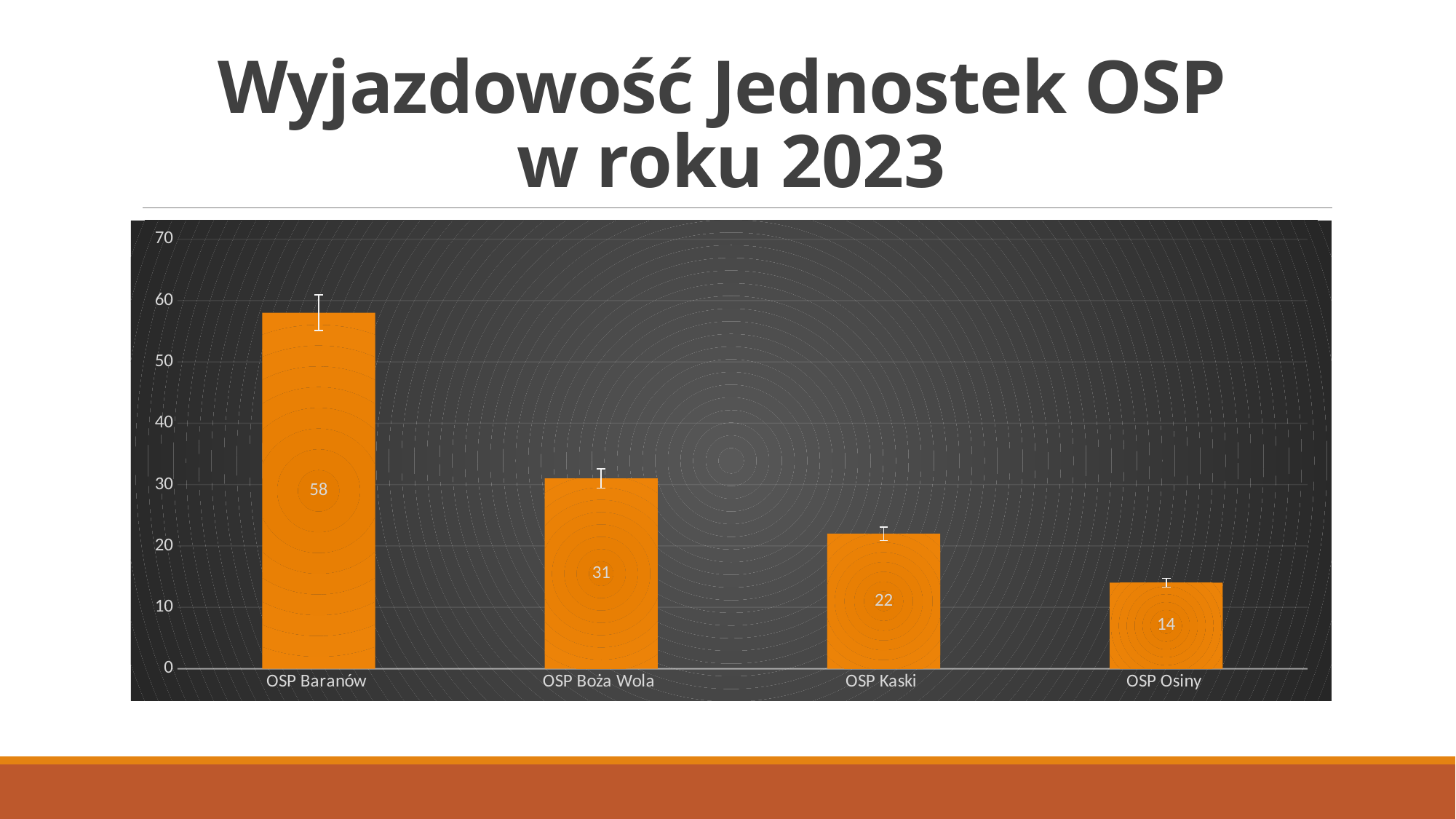
What is the difference between the values for OSP Kaski and OSP Osiny? 8 What is the value for OSP Osiny? 14 How many units are shown on the chart? 4 What is the value for OSP Baranów? 58 What is the value for OSP Kaski? 22 Which unit has the highest value? OSP Baranów What kind of chart is shown on the slide? Bar chart Which unit has the lowest value? OSP Osiny Do the values rise or fall from left to right across the chart? Fall What is the value for OSP Boża Wola? 31 Which is larger, the value for OSP Boża Wola or OSP Kaski? OSP Boża Wola What is the difference between the values for OSP Baranów and OSP Boża Wola? 27